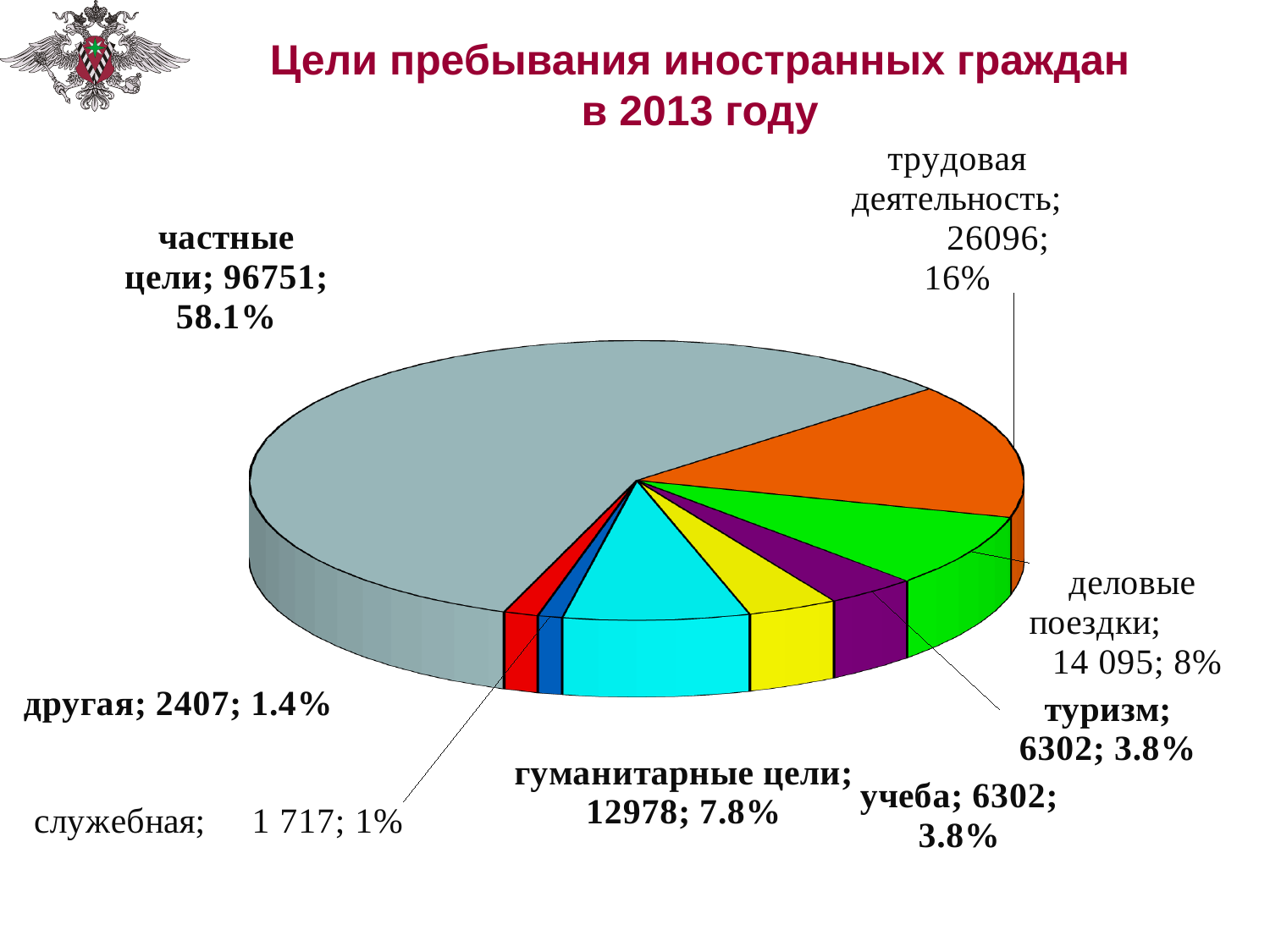
What share of the pie does "гуманитарные цели" have? 7.8% How many categories (slices) does the pie chart show? 8 What is the difference between the values for "трудовая деятельность" and "деловые поездки"? 12001 What kind of chart is shown on the slide? pie chart What is the value for "деловые поездки"? 14 095 Which category has the largest slice? частные цели What share of the pie does "трудовая деятельность" have? 16% Which category has the smallest slice? служебная What is the value for "другая"? 2407 What is the value for "частные цели"? 96751 What is the title of the chart? Цели пребывания иностранных граждан в 2013 году Which is larger, the value for "гуманитарные цели" or the value for "туризм"? гуманитарные цели